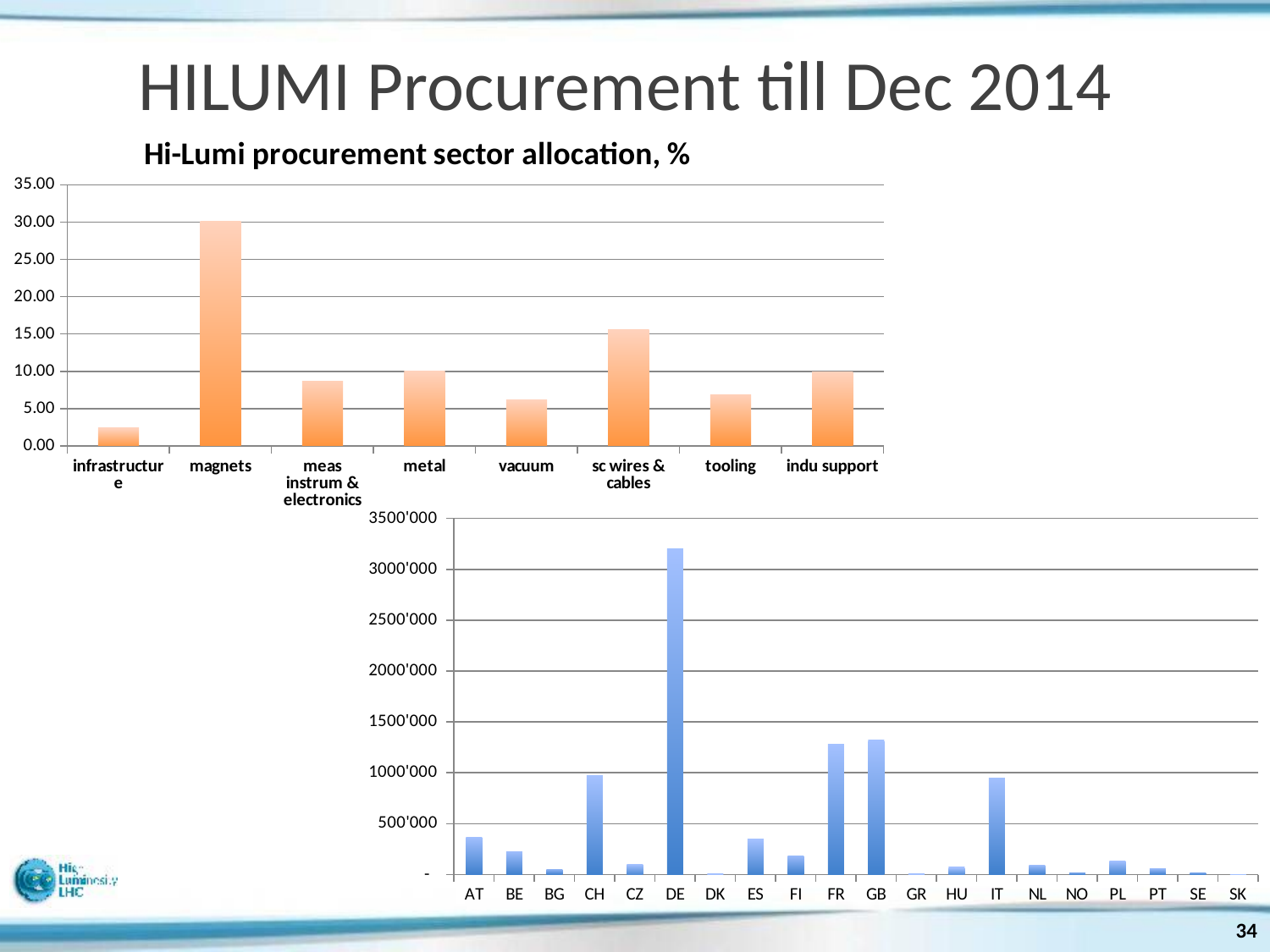
In the bottom chart showing values by country code, which country has the highest value? DE In the top chart titled 'Hi-Lumi procurement sector allocation, %', is the value for sc wires & cables greater or less than 20.00? less In the bottom chart showing values by country code, is the value for DE greater or less than 3000'000? greater In the top chart titled 'Hi-Lumi procurement sector allocation, %', how many sector categories are shown on the x axis? 8 In the top chart titled 'Hi-Lumi procurement sector allocation, %', what kind of chart is shown? bar chart In the top chart titled 'Hi-Lumi procurement sector allocation, %', which is larger, the value for vacuum or the value for metal? metal In the top chart titled 'Hi-Lumi procurement sector allocation, %', which sector has the lowest value? infrastructure What is the title of the top chart on the slide? Hi-Lumi procurement sector allocation, % In the top chart titled 'Hi-Lumi procurement sector allocation, %', is the value for magnets greater or less than 25.00? greater In the top chart titled 'Hi-Lumi procurement sector allocation, %', which sector has the highest value? magnets In the bottom chart showing values by country code, how many countries are shown on the x axis? 20 In the bottom chart showing values by country code, which is larger, the value for CH or the value for FR? FR